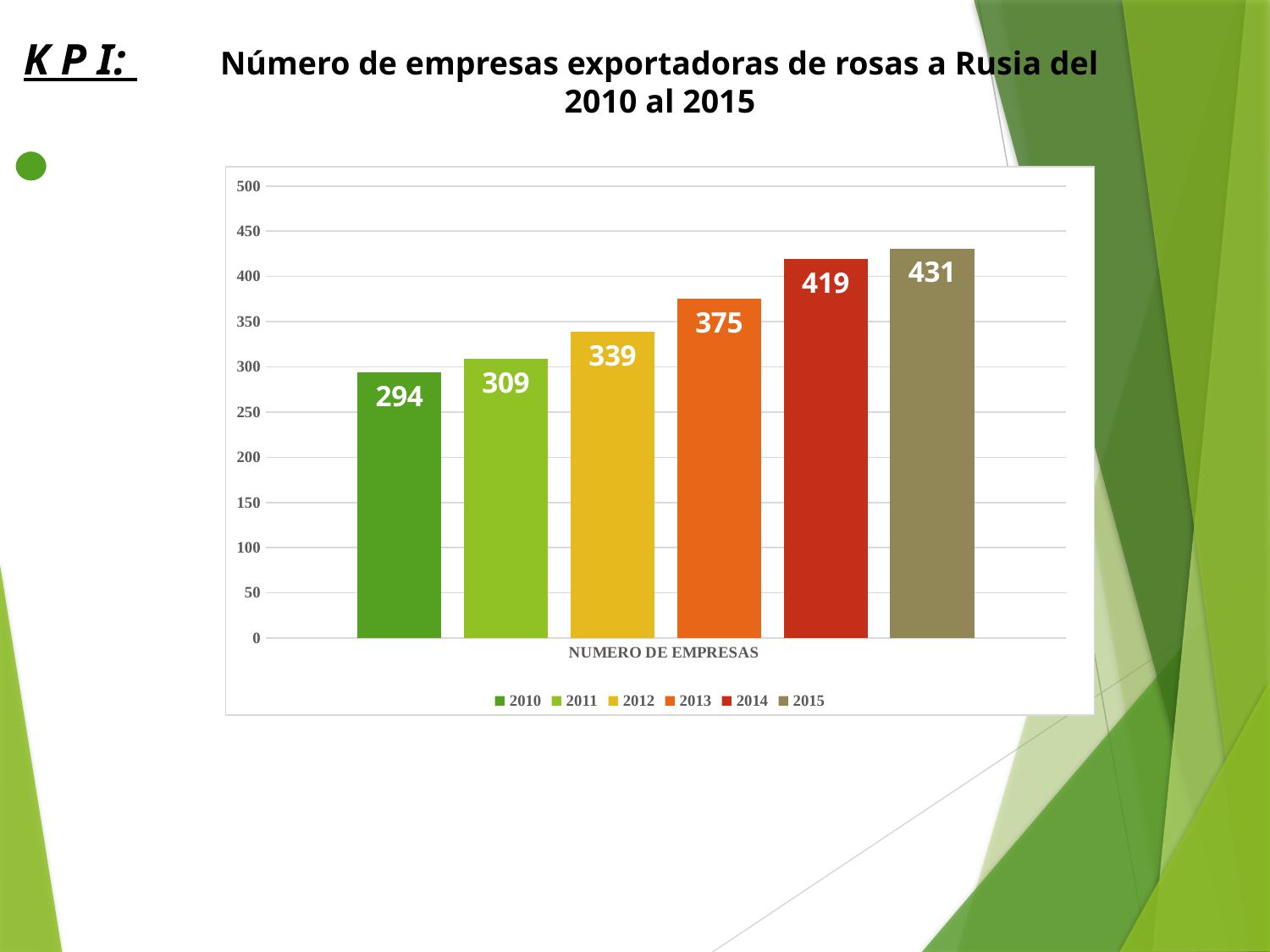
What is the number of companies for 2010? 294 What is the number of companies for 2013? 375 What is the difference between the values for 2015 and 2010? 137 What is the number of companies for 2015? 431 Which is larger, the value for 2012 or the value for 2011? 2012 Which year has the highest number of companies? 2015 Do the values rise or fall from 2010 to 2015? rise Which year has the lowest number of companies? 2010 What kind of chart is shown on the slide? bar chart How many series does the legend list? 6 Is the value for 2014 greater or less than 400? greater What is the difference between the values for 2014 and 2013? 44